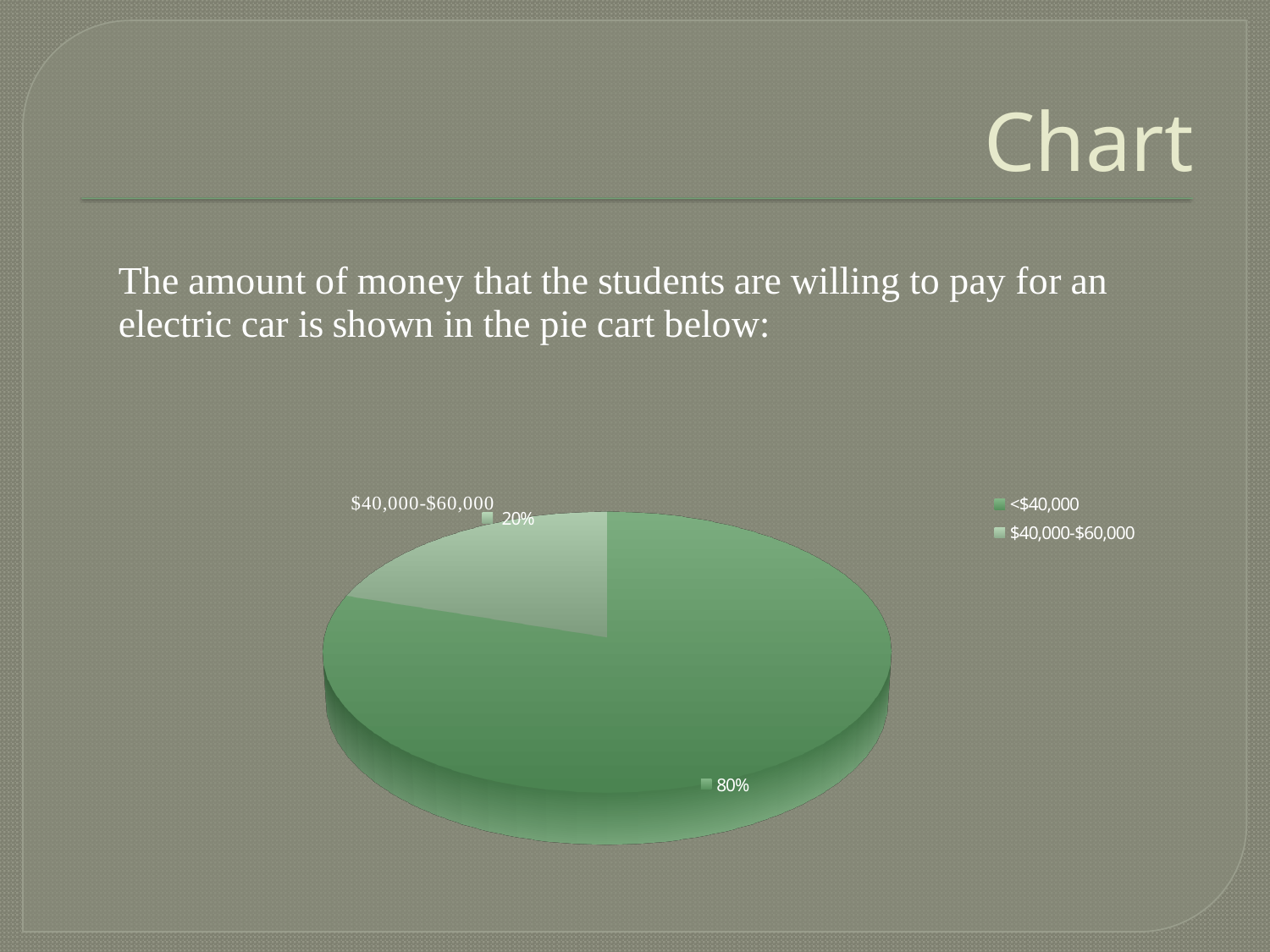
What kind of chart is shown on the slide? pie chart Which category has the largest slice of the pie? <$40,000 What is the difference in percentage points between the <$40,000 slice and the $40,000-$60,000 slice? 60 How many entries does the legend list? 2 Which category has the smallest slice of the pie? $40,000-$60,000 What share of the pie does the $40,000-$60,000 slice represent? 20% How many slices does the pie chart have? 2 What is the first entry listed in the legend? <$40,000 Which slice is larger, <$40,000 or $40,000-$60,000? <$40,000 What is the title of the slide containing the pie chart? Chart What share of the pie does the <$40,000 slice represent? 80%